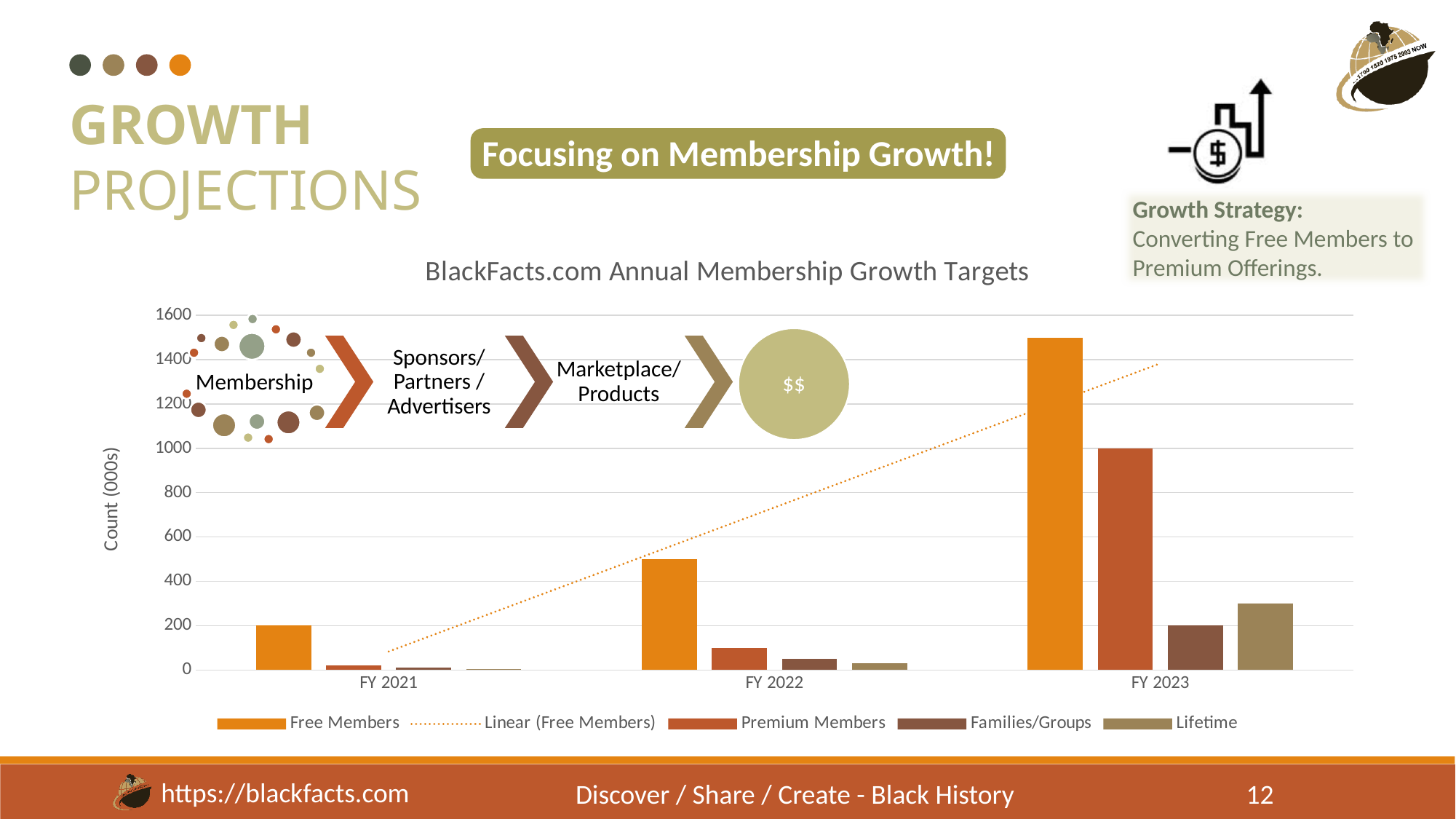
How many entries does the chart legend list? 5 Which fiscal year has the highest value for Free Members? FY 2023 Do the Free Members values rise or fall from FY 2021 to FY 2023? rise Is the value for Free Members in FY 2023 greater or less than 1400? greater What is the value for Families/Groups in FY 2023? 200 What is the value for Premium Members in FY 2023? 1000 What is the value for Free Members in FY 2021? 200 What is the title of the chart? BlackFacts.com Annual Membership Growth Targets What is the label of the y axis? Count (000s) What kind of chart is shown on the slide? bar chart Is the value for Free Members in FY 2022 greater or less than 400? greater How many fiscal years are shown on the x axis of the chart? 3